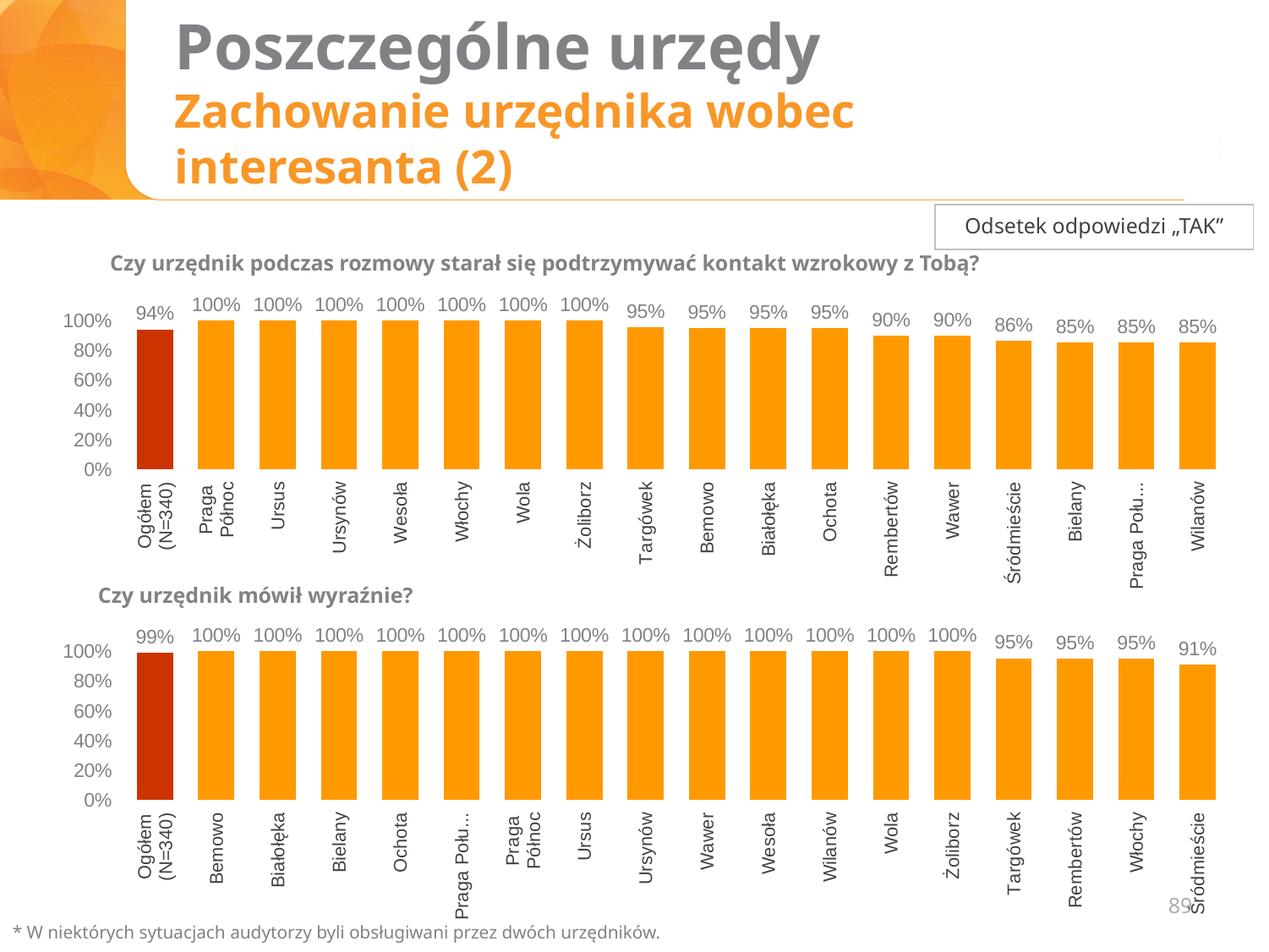
In the bottom chart (Czy urzędnik mówił wyraźnie?), what is the value for Ogółem (N=340)? 99% In the bottom chart (Czy urzędnik mówił wyraźnie?), which category has the lowest value? Śródmieście What type of chart is the top chart (eye contact question)? Bar chart In the bottom chart (Czy urzędnik mówił wyraźnie?), what is the value for Śródmieście? 91% In the bottom chart (Czy urzędnik mówił wyraźnie?), what is the difference between the values for Bemowo and Targówek? 5% In the top chart (eye contact question), which is larger, the value for Targówek or the value for Bielany? Targówek In the top chart (eye contact question), what is the value for Śródmieście? 86% In the top chart (eye contact question), what is the difference between the values for Ursus and Wilanów? 15% In the top chart (eye contact question), what is the value for Ogółem (N=340)? 94% How many categories are shown in the bottom chart (Czy urzędnik mówił wyraźnie?)? 18 In the top chart (eye contact question), what is the value for Rembertów? 90% In the bottom chart (Czy urzędnik mówił wyraźnie?), what is the value for Włochy? 95%